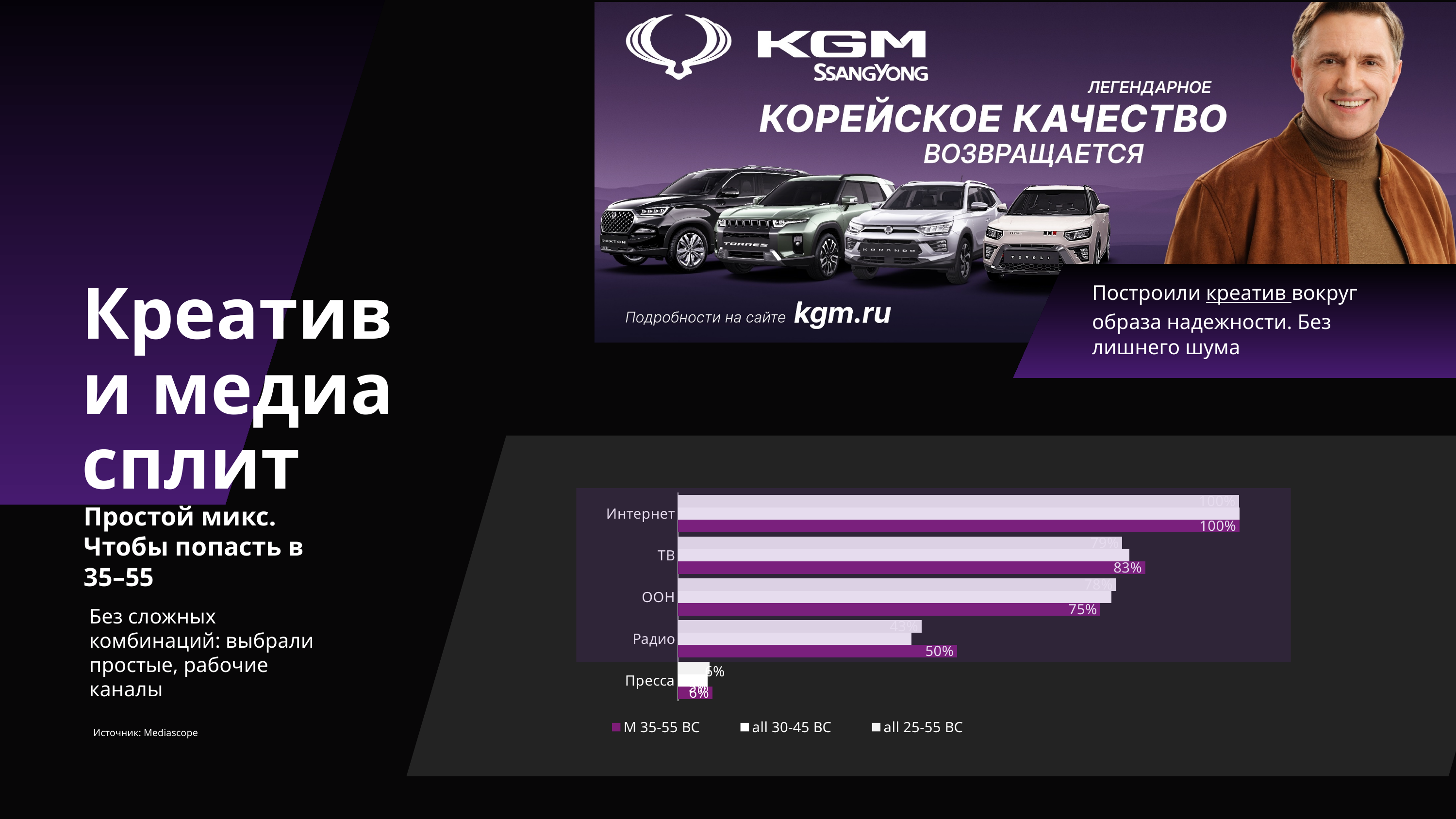
What is the value for Радио in the M 35-55 BC series? 50% In the M 35-55 BC series, which is larger: ТВ or ООН? ТВ Which category has the highest value in the M 35-55 BC series? Интернет What is the difference between the M 35-55 BC values for ТВ and Радио? 33% How many categories are shown on the chart? 5 Which series is shown in purple according to the legend? M 35-55 BC How many series does the legend list? 3 Which category has the lowest value in the M 35-55 BC series? Пресса What is the value for ООН in the M 35-55 BC series? 75% What kind of chart is shown on the slide? Bar chart What is the value for ТВ in the M 35-55 BC series? 83% What is the value for Интернет in the M 35-55 BC series? 100%